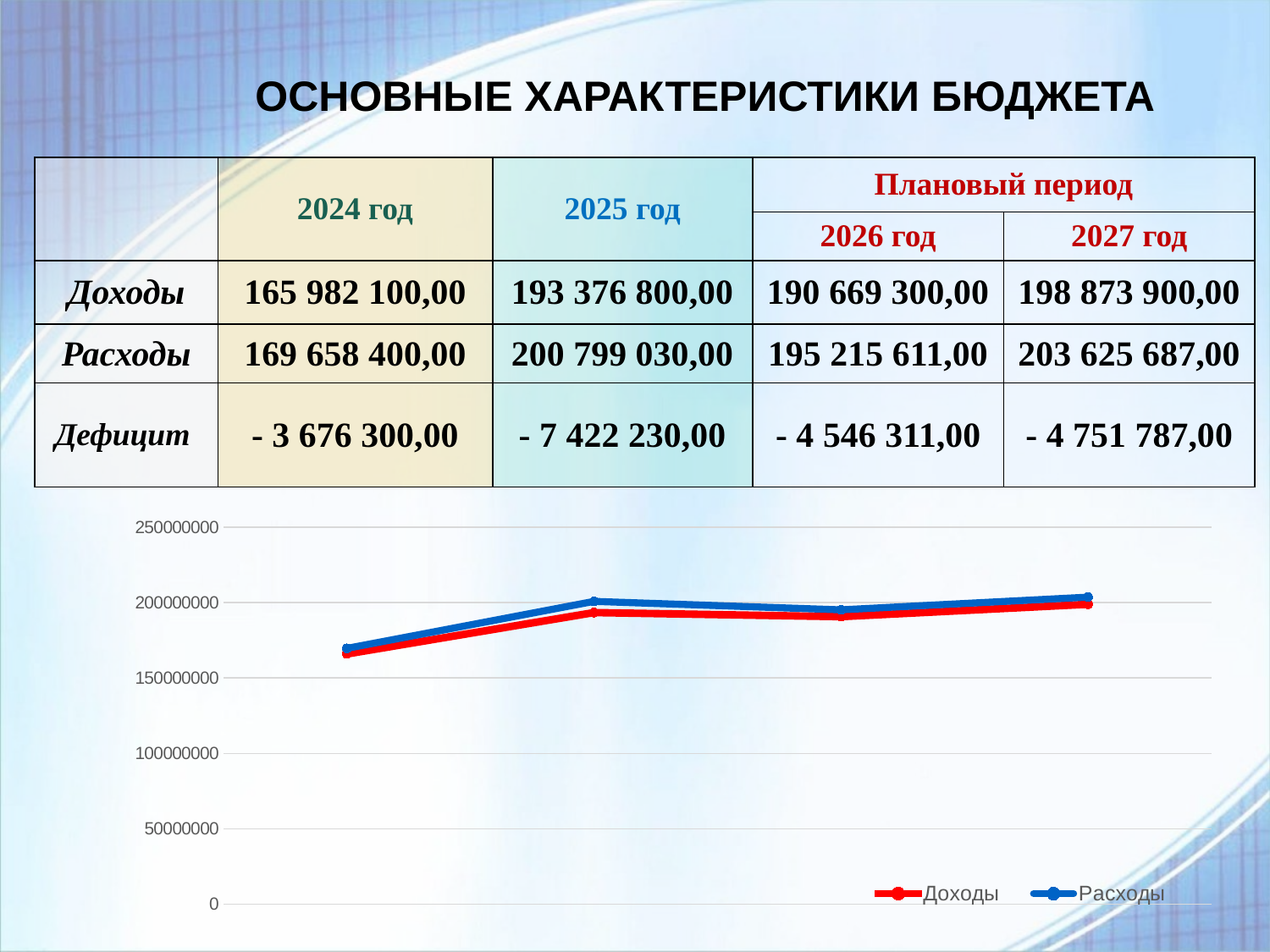
How many data points does each line in the chart have? 4 Which two series are listed in the chart legend? Доходы and Расходы Which series is higher at every point in the chart, Доходы or Расходы? Расходы What is the highest value shown on the chart's vertical axis? 250000000 What colour is the Расходы line in the chart? blue Do the lines in the chart rise or fall from the first point to the second point? rise How many series does the chart legend list? 2 Is the first point of the Доходы line greater or less than 150000000? greater Is the first point of the Расходы line greater or less than 200000000? less What kind of chart is shown on the slide? line chart Is the highest point of the Расходы line greater or less than 250000000? less Do the lines in the chart rise or fall from the second point to the third point? fall